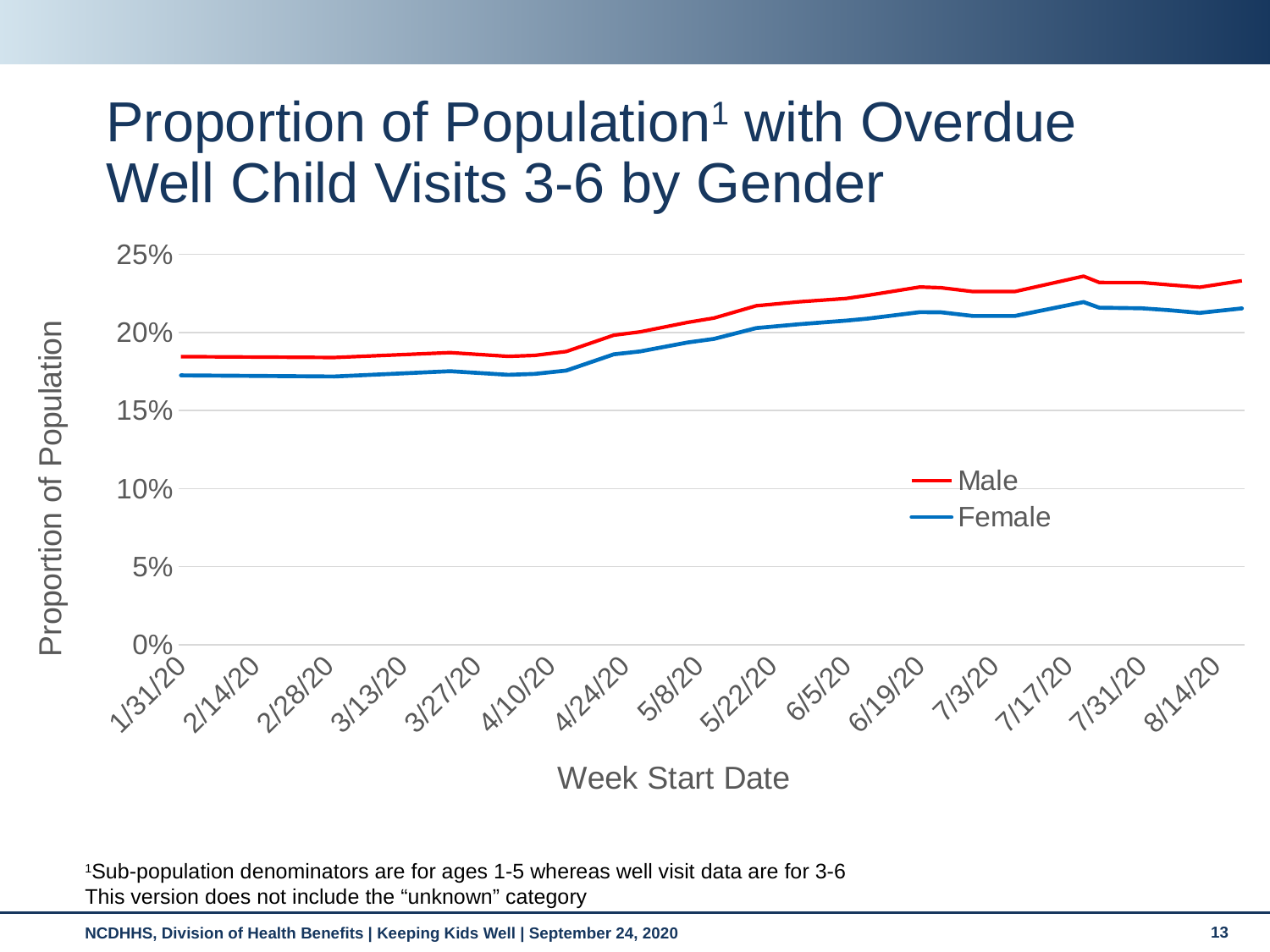
Is the value for Male at 1/31/20 greater or less than 20%? less Do the Male values generally rise or fall from 1/31/20 to 8/14/20? rise How many series does the legend list? 2 Is the value for Female at 6/19/20 greater or less than 20%? greater Which series has the higher value at 6/19/20, Male or Female? Male What kind of chart is shown on the slide? line chart Is the value for Male at 8/14/20 greater or less than 20%? greater Which series has the lower value at 1/31/20, Male or Female? Female Which series is plotted in red? Male Do the Female values generally rise or fall from 1/31/20 to 8/14/20? rise What is the title of the x axis? Week Start Date